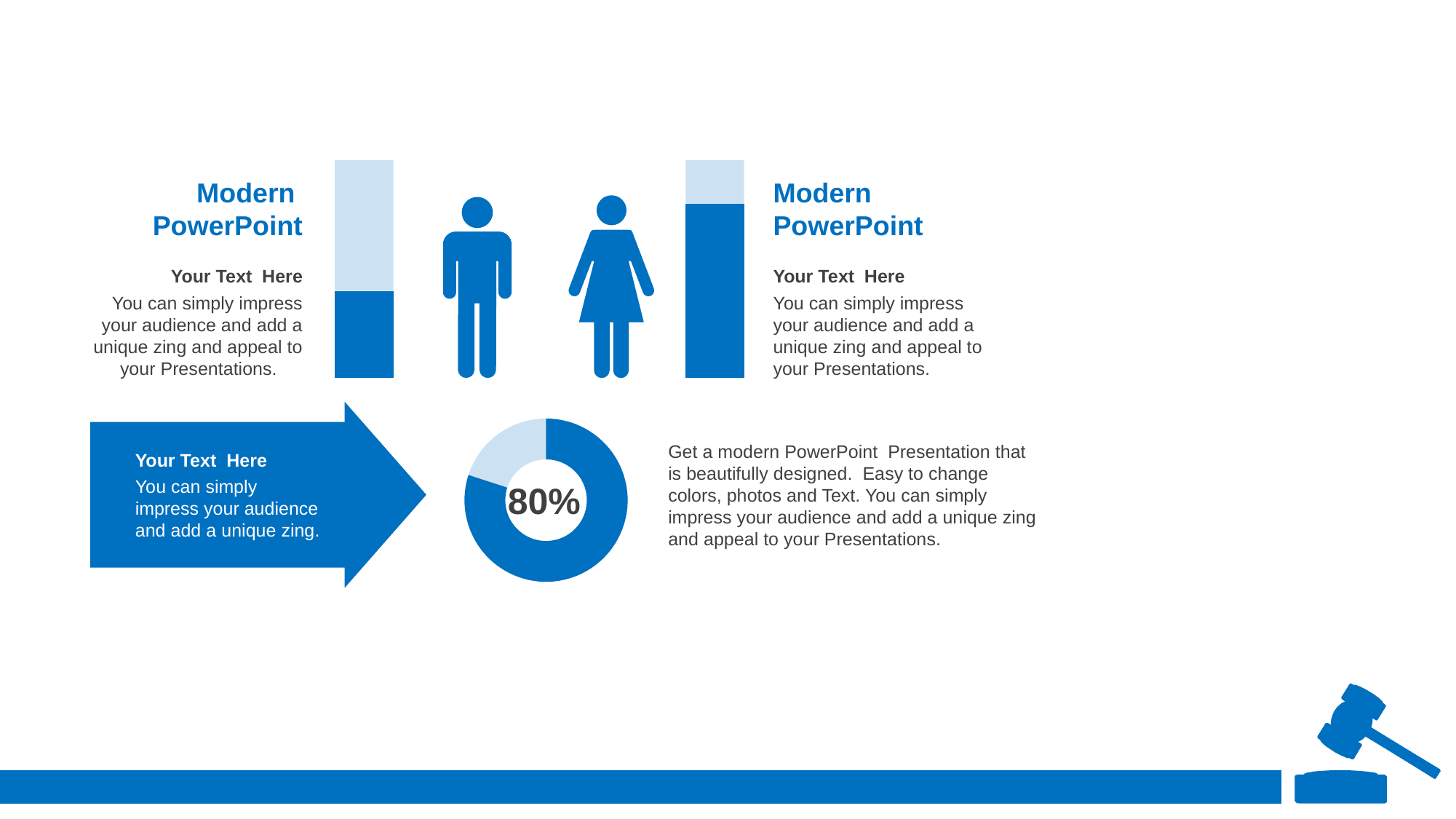
What share of the donut chart does the light blue slice represent? 20% What share of the donut chart does the dark blue slice represent? 80% In the donut chart, which slice is larger, the dark blue one or the light blue one? Dark blue What kind of chart is shown in the lower middle of the slide? Pie (donut) chart What value is printed in the centre of the donut chart? 80% How many slices does the donut chart have? 2 Is the value shown in the donut chart greater or less than 50%? greater What colour is the larger slice of the donut chart? Dark blue